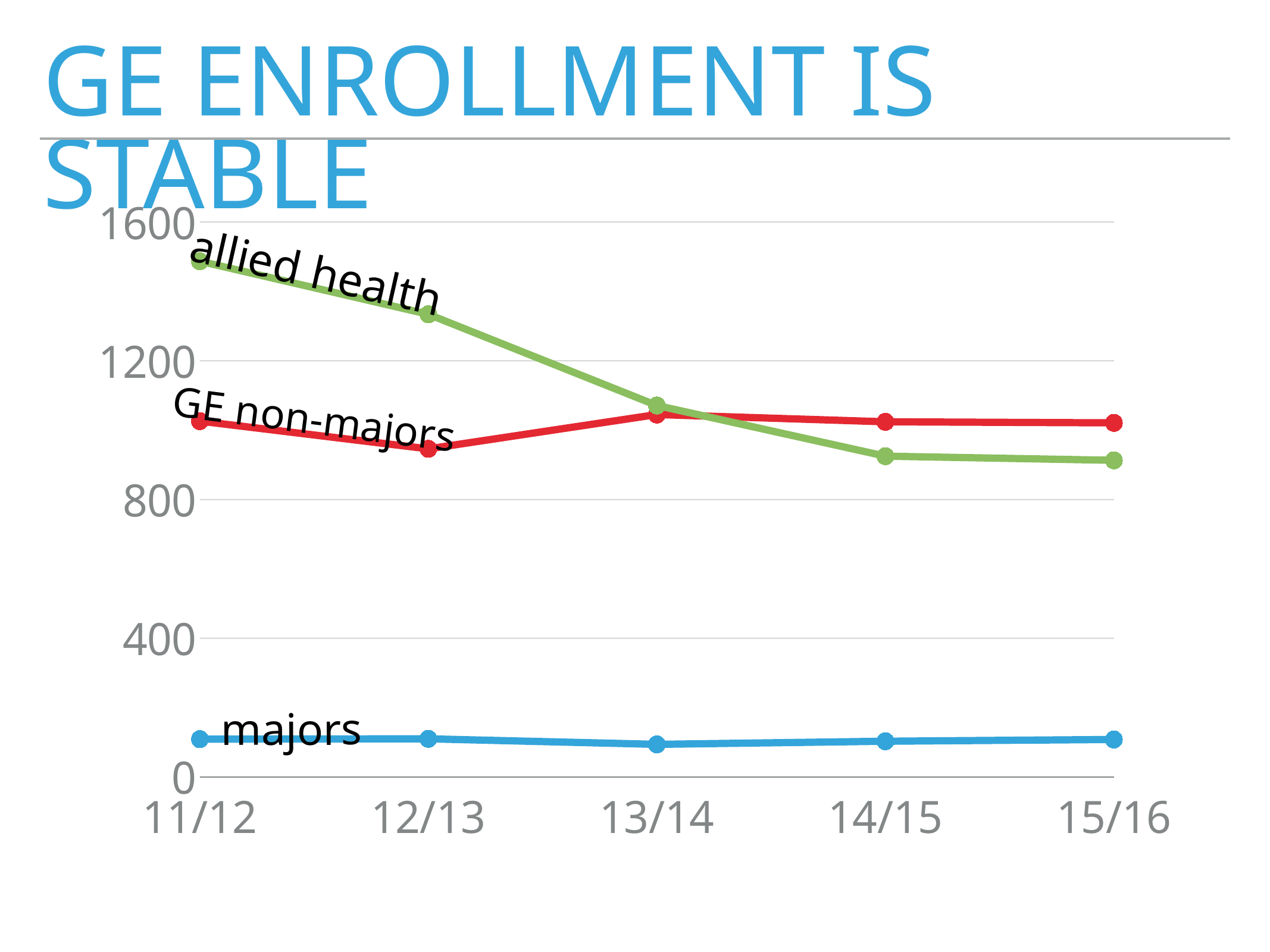
What is the title of the slide? GE ENROLLMENT IS STABLE Is the value for GE non-majors in 12/13 greater or less than 800? greater How many data series are plotted on the chart? 3 How many academic years are shown on the x axis? 5 Is the value for allied health in 15/16 greater or less than 1200? less In 15/16, which is larger: GE non-majors or allied health? GE non-majors In 11/12, which is larger: allied health or GE non-majors? allied health Which series has the lowest value in 15/16? majors What kind of chart is shown on the slide? line chart Is the value for allied health in 11/12 greater or less than 1200? greater Does the allied health line rise or fall from 11/12 to 15/16? fall